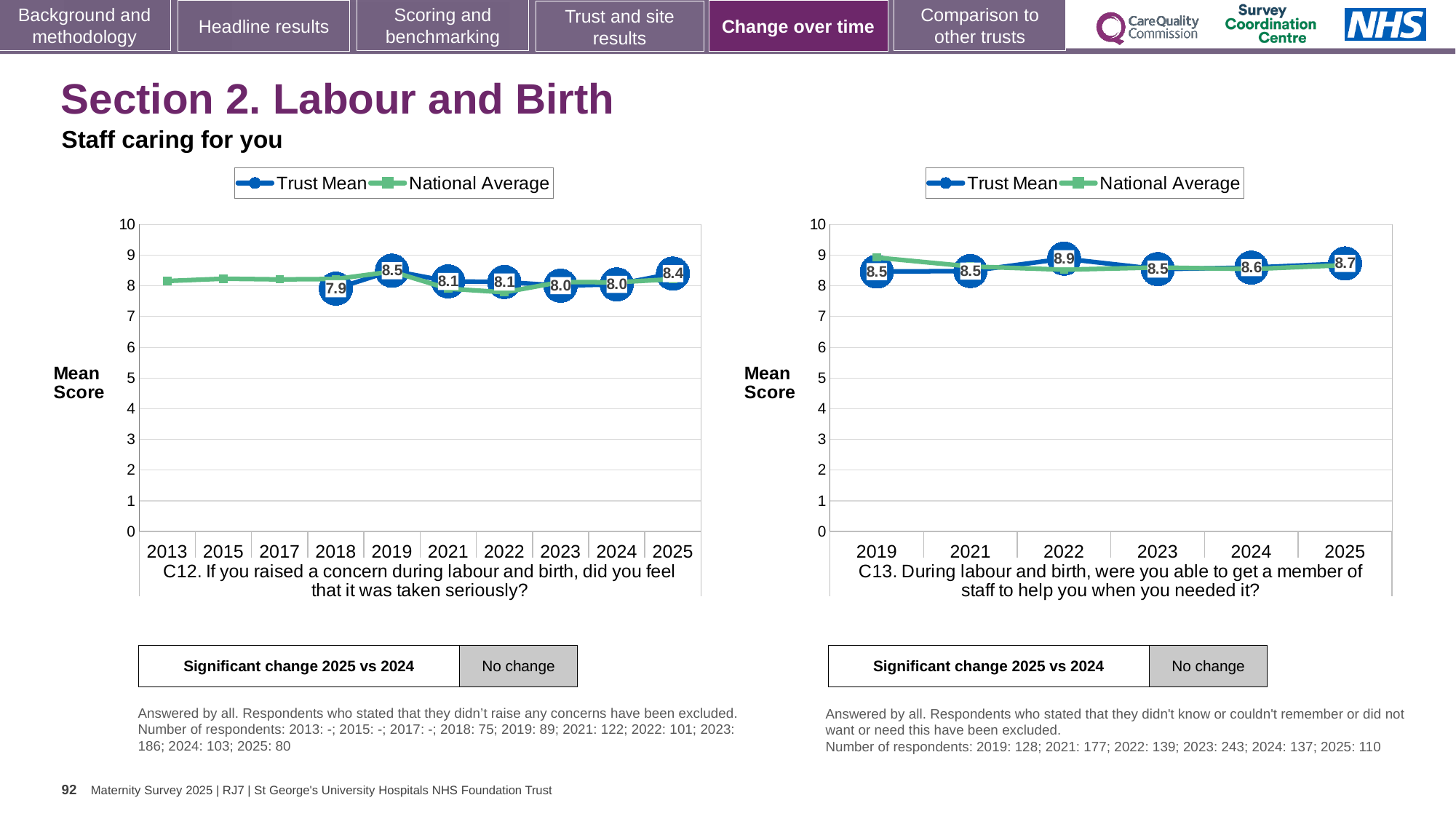
In the C13 chart (right), what is the Trust Mean for 2022? 8.9 In the C12 chart (left), what is the difference between the Trust Mean for 2025 and 2024? 0.4 In the C12 chart (left), what is the Trust Mean for 2018? 7.9 In the C12 chart (left), how many years are shown on the x axis? 10 In the C13 chart (right), is the Trust Mean for 2025 larger or smaller than for 2024? larger In the C12 chart (left), is the National Average for 2013 greater or less than 7? greater What type of chart is the C13 chart (right)? line chart In the C13 chart (right), how many series does the legend list? 2 In the C13 chart (right), which year has the highest Trust Mean? 2022 In the C12 chart (left), which year has the lowest Trust Mean? 2018 In the C12 chart (left), what is the Trust Mean for 2025? 8.4 In the C12 chart (left), which year has the highest Trust Mean? 2019